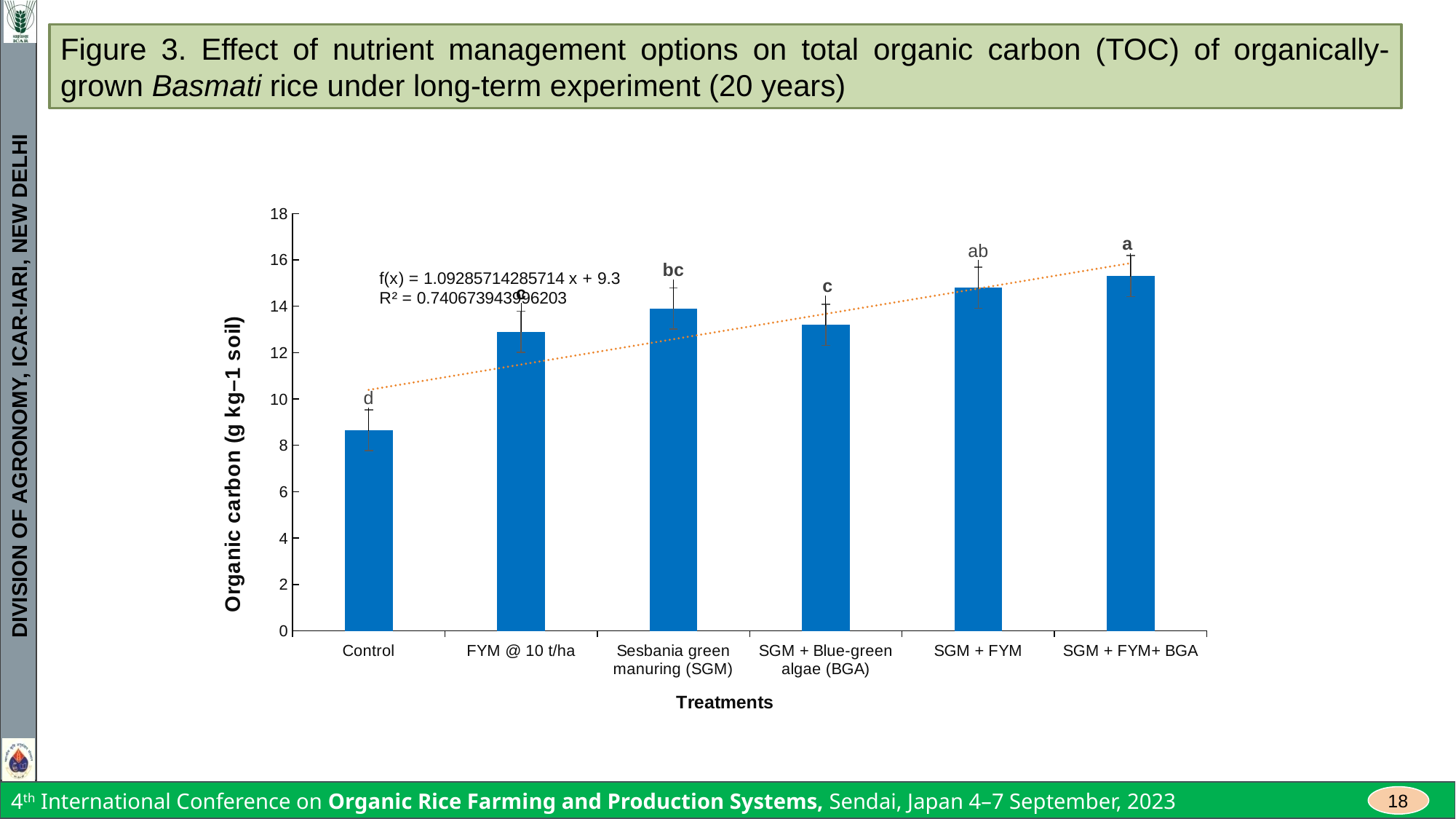
Which has a higher organic carbon value, Control or FYM @ 10 t/ha? FYM @ 10 t/ha Is the organic carbon value for SGM + FYM+ BGA greater or less than 14? greater Which treatment has the lowest organic carbon value? Control What is the title of the y axis? Organic carbon (g kg–1 soil) Do the organic carbon values generally rise or fall from Control to SGM + FYM+ BGA along the x axis? rise Is the organic carbon value for SGM + FYM greater or less than 16? less Is the organic carbon value for Control greater or less than 10? less What kind of chart is shown on the slide? bar chart Which treatment has the highest organic carbon value? SGM + FYM+ BGA Which has a higher organic carbon value, SGM + Blue-green algae (BGA) or SGM + FYM? SGM + FYM How many treatments are plotted on the x axis? 6